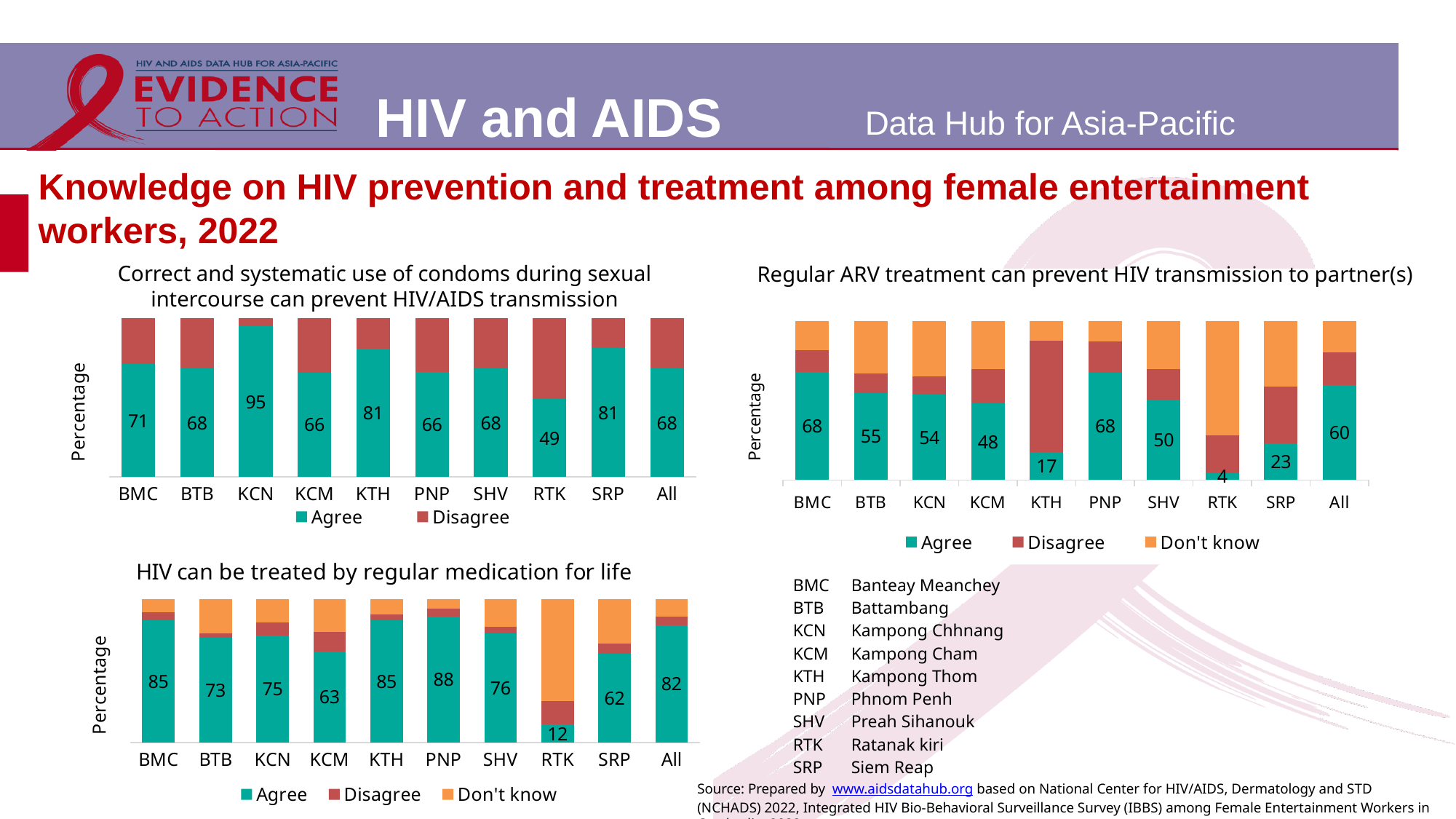
In the chart titled "HIV can be treated by regular medication for life", what is the Agree value for PNP? 88 In the chart titled "Regular ARV treatment can prevent HIV transmission to partner(s)", how many series does the legend list? 3 In the chart titled "HIV can be treated by regular medication for life", which category has the highest Agree value? PNP In the chart titled "Correct and systematic use of condoms during sexual intercourse can prevent HIV/AIDS transmission", how many series does the legend list? 2 In the chart titled "Correct and systematic use of condoms during sexual intercourse can prevent HIV/AIDS transmission", what is the difference between the Agree values for KCN and RTK? 46 In the chart titled "Correct and systematic use of condoms during sexual intercourse can prevent HIV/AIDS transmission", what is the Agree value for KCN? 95 What kind of chart is the chart titled "HIV can be treated by regular medication for life"? Stacked bar chart In the chart titled "Correct and systematic use of condoms during sexual intercourse can prevent HIV/AIDS transmission", which province has the lowest Agree value? RTK In the chart titled "Regular ARV treatment can prevent HIV transmission to partner(s)", what is the Agree value for KTH? 17 In the chart titled "Regular ARV treatment can prevent HIV transmission to partner(s)", which category has the lowest Agree value? RTK In the chart titled "Regular ARV treatment can prevent HIV transmission to partner(s)", which is larger, the Agree value for BTB or for SRP? BTB In the chart titled "HIV can be treated by regular medication for life", how many categories are shown on the x axis? 10